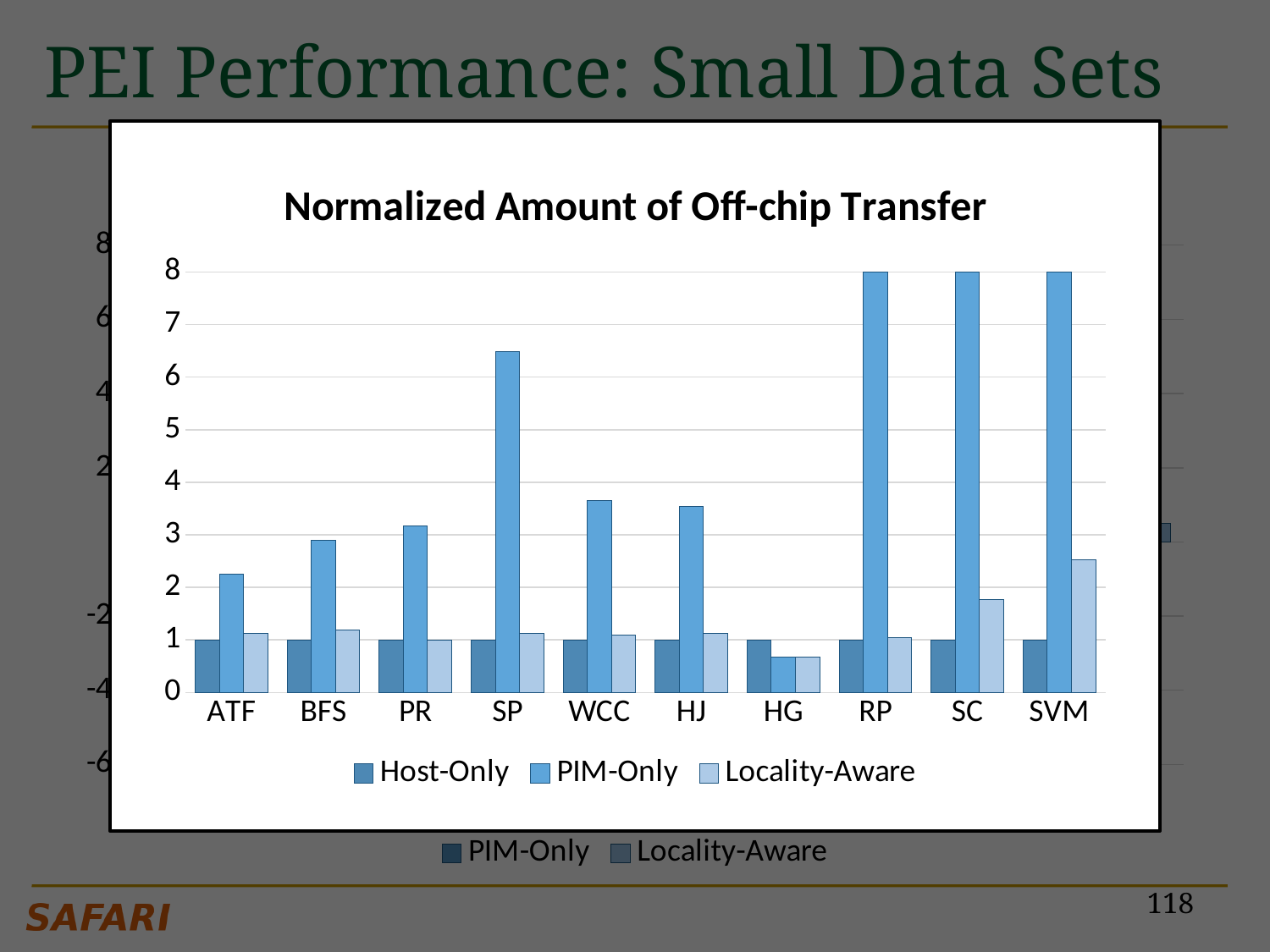
In the 'Normalized Amount of Off-chip Transfer' chart, which is larger: the Locality-Aware value for SC or the Locality-Aware value for ATF? SC In the 'Normalized Amount of Off-chip Transfer' chart, how many series does the legend list? 3 In the 'Normalized Amount of Off-chip Transfer' chart, is the Locality-Aware value for SVM greater or less than 2? greater In the 'Normalized Amount of Off-chip Transfer' chart, is the PIM-Only value for HG greater or less than 1? less What are the three series listed in the legend of the 'Normalized Amount of Off-chip Transfer' chart? Host-Only, PIM-Only, Locality-Aware In the 'Normalized Amount of Off-chip Transfer' chart, which category has the lowest PIM-Only value? HG In the 'Normalized Amount of Off-chip Transfer' chart, is the PIM-Only value for SP greater or less than 6? greater In the 'Normalized Amount of Off-chip Transfer' chart, what is the Host-Only value for ATF? 1 In the 'Normalized Amount of Off-chip Transfer' chart, which is larger: the PIM-Only value for SP or the PIM-Only value for BFS? SP In the 'Normalized Amount of Off-chip Transfer' chart, how many categories are shown on the x axis? 10 In the 'Normalized Amount of Off-chip Transfer' chart, what kind of chart is shown? bar chart